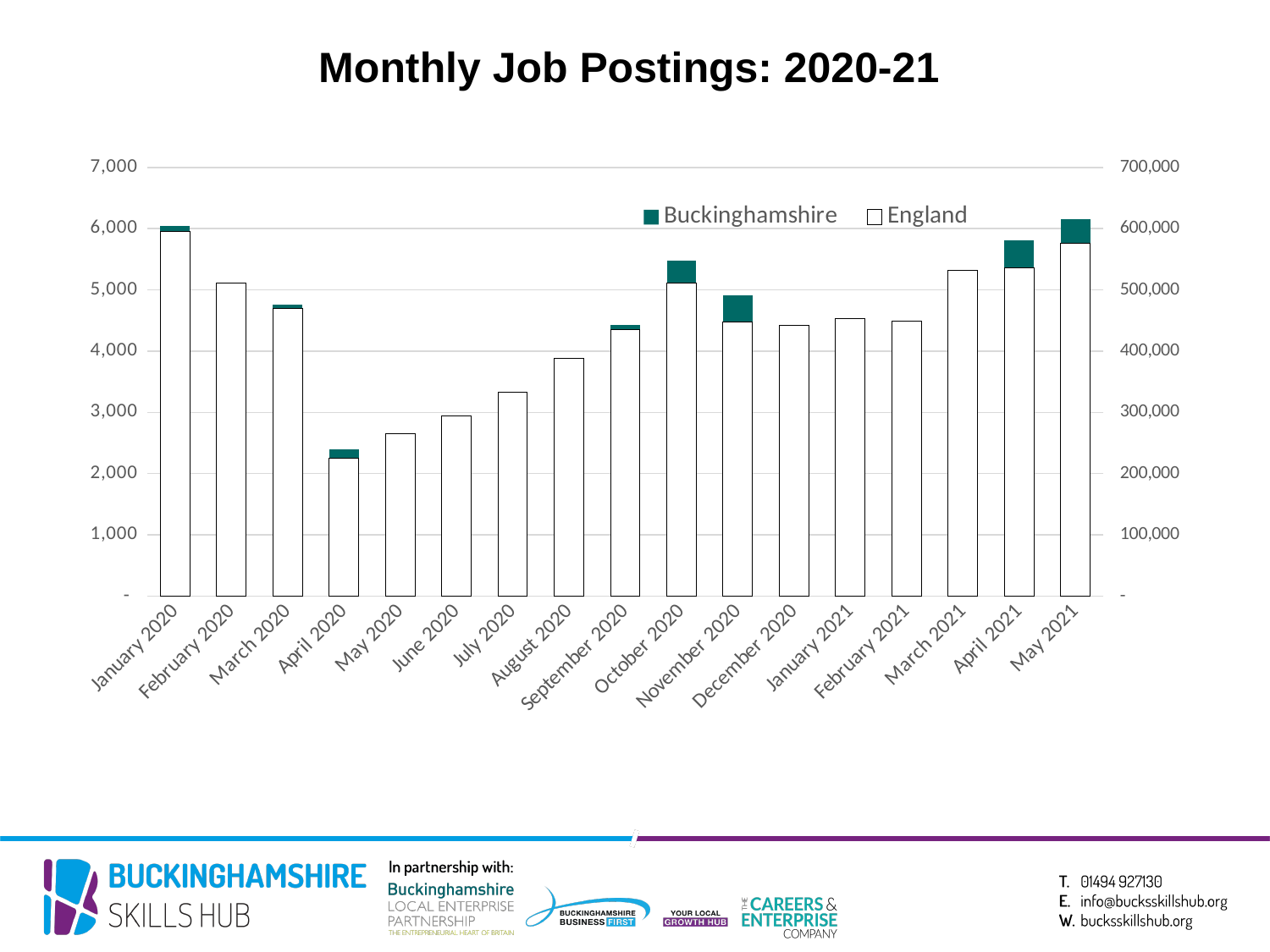
Is the value for England in January 2020 greater or less than 500,000? greater Is the value for England in July 2020 greater or less than 300,000? greater Which month has the lowest value for England? April 2020 Which is larger for England: February 2020 or April 2020? February 2020 Is the value for Buckinghamshire in October 2020 greater or less than 5,000? greater Do the England values rise or fall from April 2020 to October 2020? Rise What kind of chart is shown on the slide? Bar chart How many months are shown along the x axis? 17 How many series does the legend list? 2 What is the title of the chart? Monthly Job Postings: 2020-21